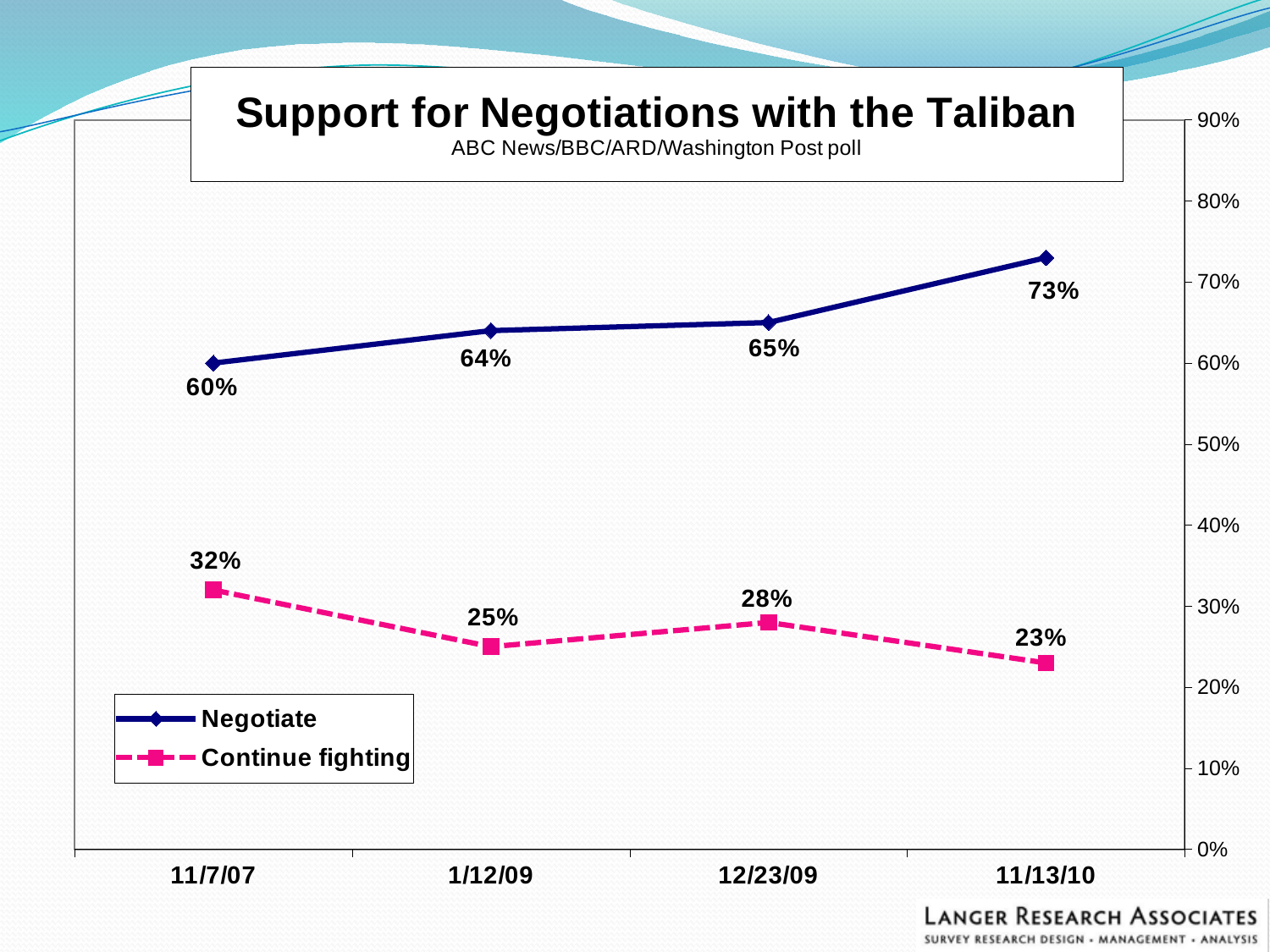
On which date is the Continue fighting value lowest? 11/13/10 How many dates are shown on the x axis? 4 What is the value for Continue fighting on 1/12/09? 25% What kind of chart is this? Line chart Which is larger on 11/7/07: Negotiate or Continue fighting? Negotiate Is the value for Negotiate on 1/12/09 greater or less than 50%? greater Does the Negotiate series rise or fall from 11/7/07 to 11/13/10? Rise How many series does the legend list? 2 What is the value for Negotiate on 11/7/07? 60% What is the difference between Negotiate and Continue fighting on 12/23/09? 37% What is the value for Negotiate on 11/13/10? 73% On which date is the Negotiate value highest? 11/13/10